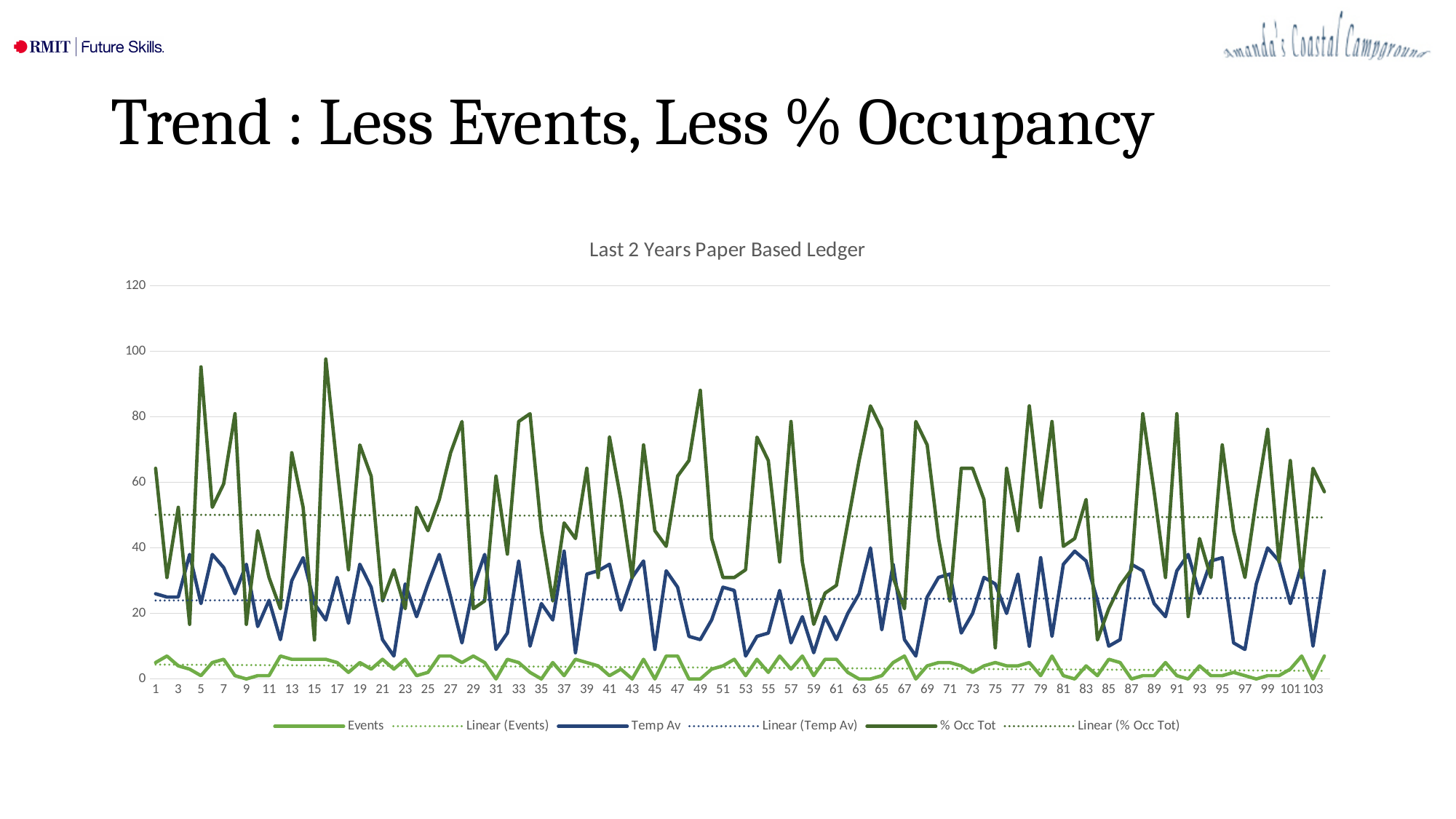
What is the highest value shown on the vertical axis? 120 Which series has the lowest values across the chart? Events Which series reaches the highest value on the chart? % Occ Tot Is the Events value at point 1 greater or less than 20? less Is the % Occ Tot value at point 16 greater or less than 80? greater How many entries does the chart legend list? 6 Is the Temp Av value at point 49 greater or less than 20? less What is the title of the chart? Last 2 Years Paper Based Ledger At point 5, which is larger: % Occ Tot or Temp Av? % Occ Tot According to the slide title, are events and % occupancy trending up or down? down What kind of chart is shown on the slide? line chart